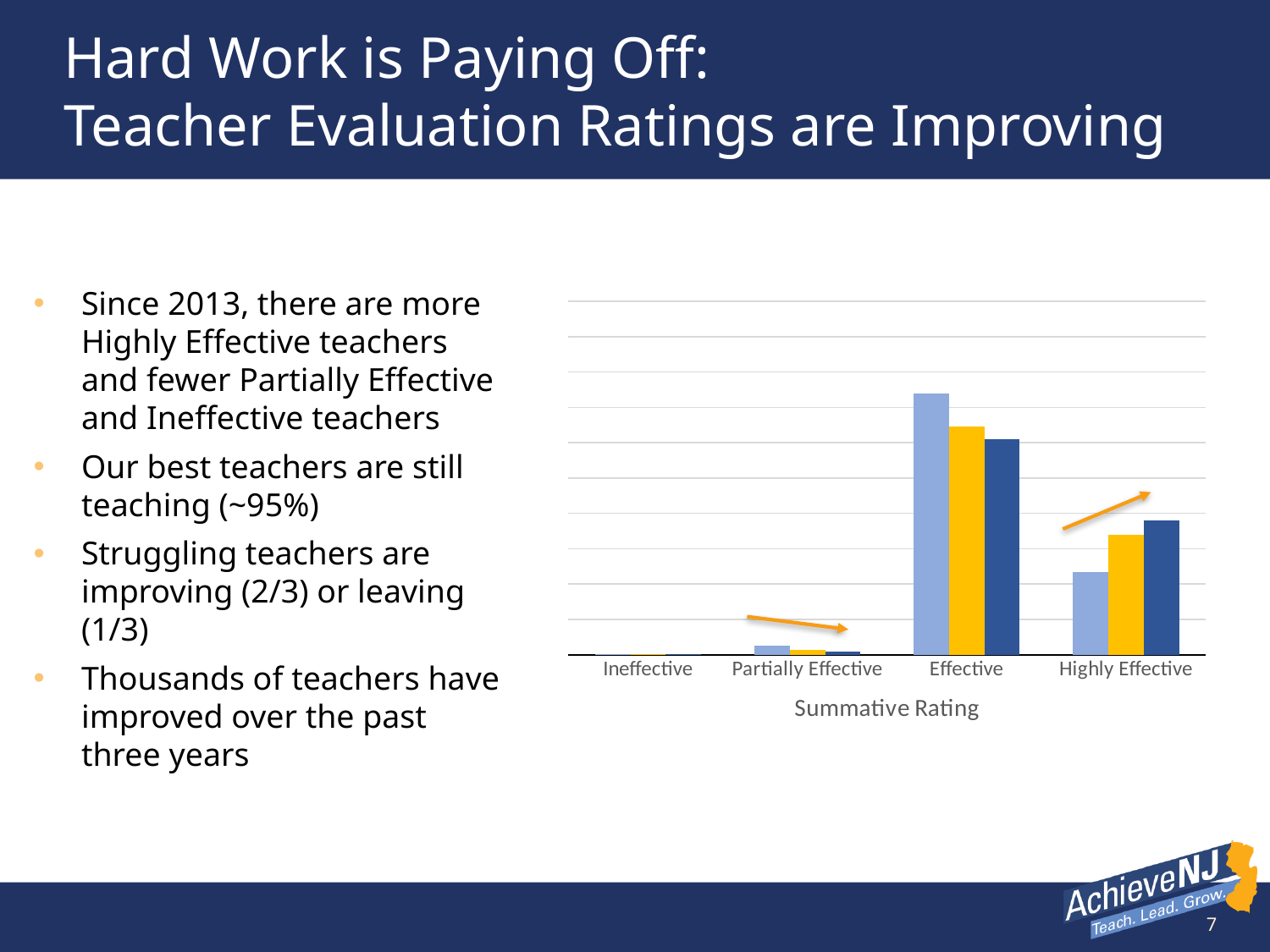
Within the Effective category, do the bars rise or fall from left to right? fall What kind of chart is shown on the slide? bar chart What colour is the middle bar in each category of the chart? yellow Within the Highly Effective category, do the bars rise or fall from left to right? rise How many summative rating categories are shown on the x axis of the chart? 4 Which category has taller bars in the chart, Effective or Highly Effective? Effective Which summative rating category has the tallest bars in the chart? Effective Which summative rating category has the shortest bars in the chart? Ineffective Within the Partially Effective category, do the bars rise or fall from left to right? fall What is the title of the x axis of the chart? Summative Rating How many bars are plotted for the Highly Effective category? 3 Which category has taller bars in the chart, Partially Effective or Highly Effective? Highly Effective